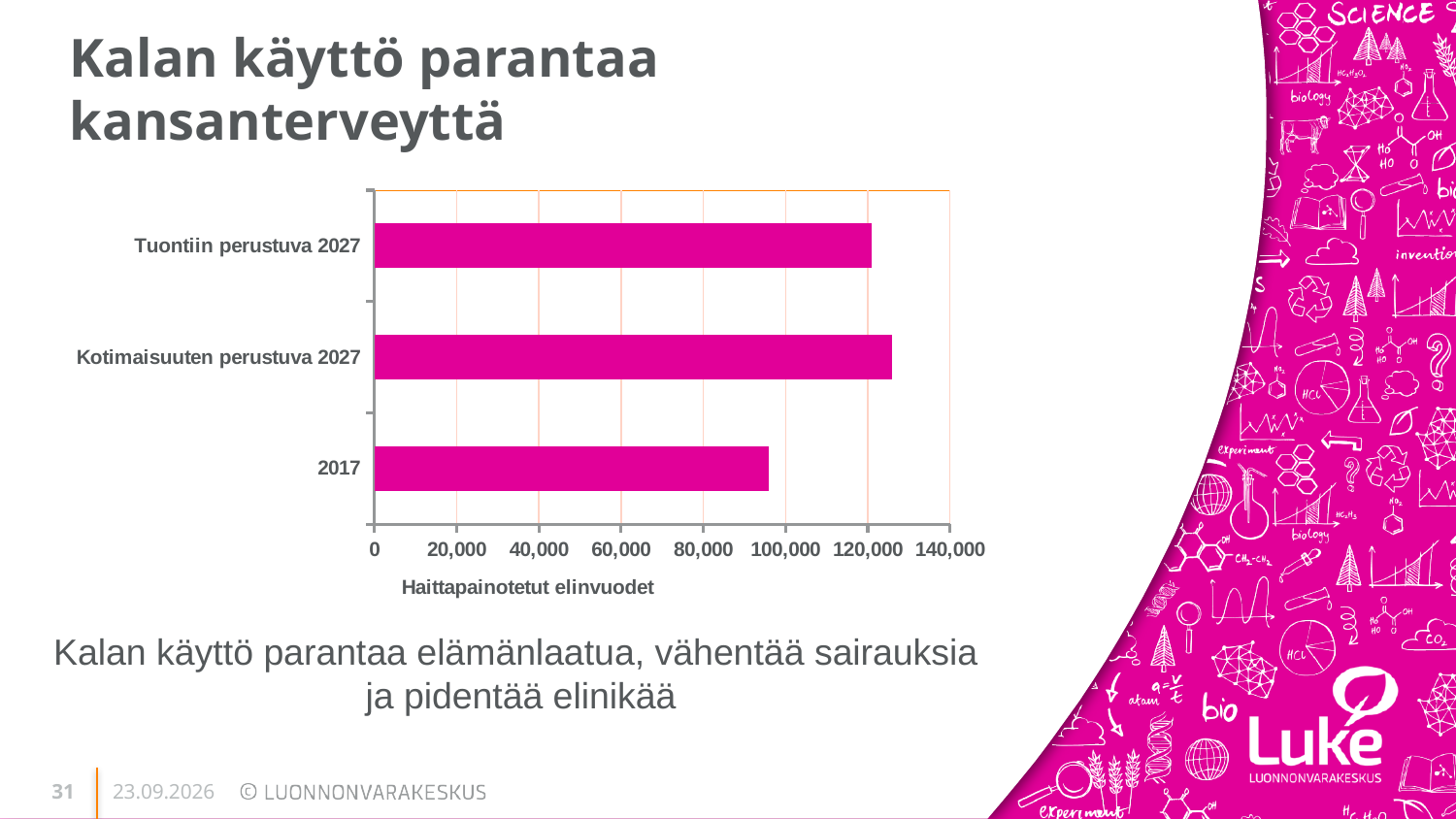
Is the value for Kotimaisuuten perustuva 2027 greater or less than 120,000? greater What is the title of the horizontal axis of the chart? Haittapainotetut elinvuodet How many categories are plotted in the chart? 3 What is the highest value shown on the horizontal axis of the chart? 140,000 Is the value for 2017 greater or less than 80,000? greater Is the value for Tuontiin perustuva 2027 greater or less than 100,000? greater Which is larger, the value for 2017 or the value for Tuontiin perustuva 2027? Tuontiin perustuva 2027 What kind of chart is shown on the slide? bar chart Which category has the lowest value in the chart? 2017 Which is larger, the value for 2017 or the value for Kotimaisuuten perustuva 2027? Kotimaisuuten perustuva 2027 Which category has the highest value in the chart? Kotimaisuuten perustuva 2027